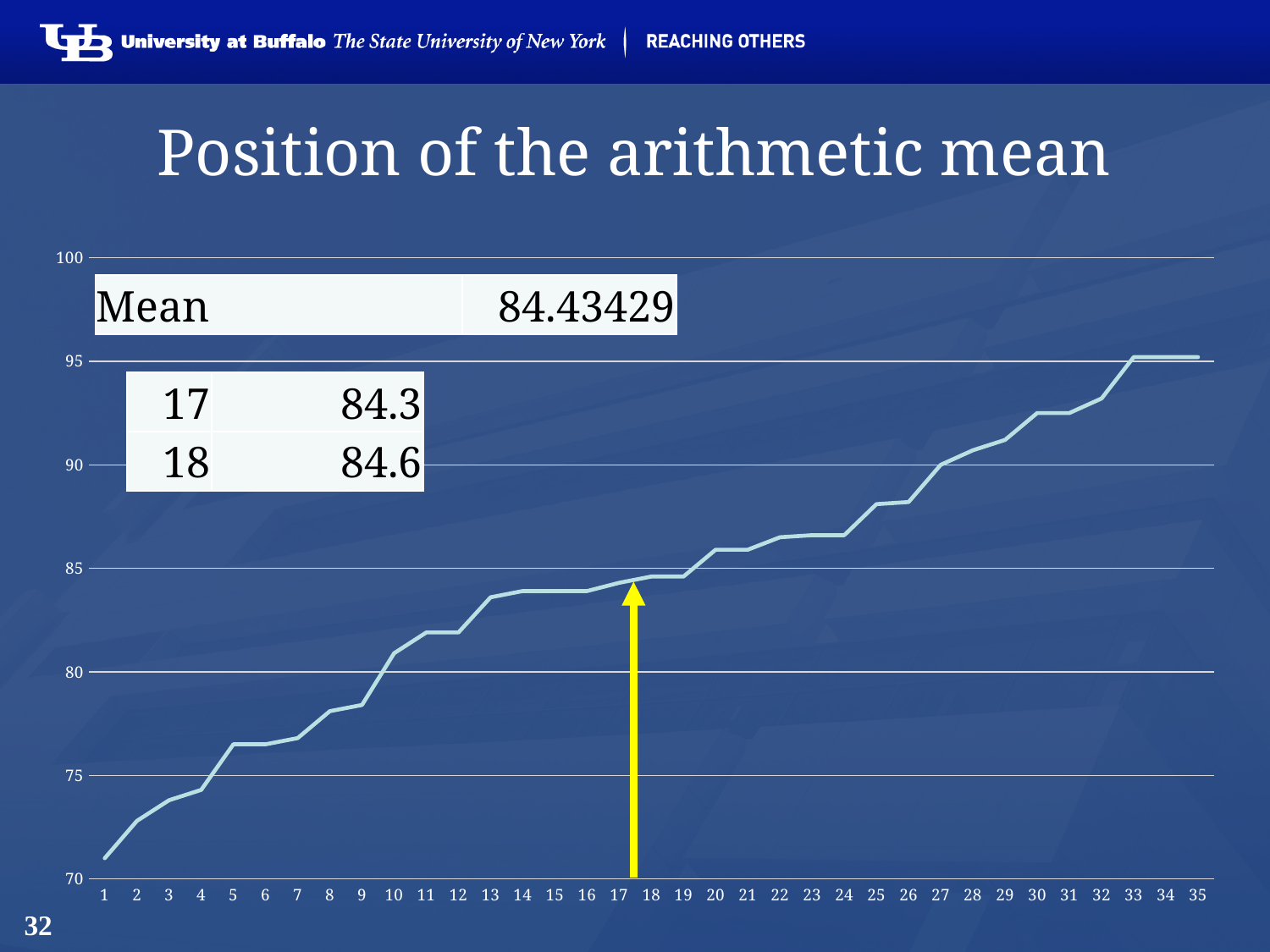
How many points are plotted along the x axis of the chart? 35 Is the value at position 9 greater or less than 80? less What is the value at position 18 according to the table on the chart? 84.6 What is the difference between the values at positions 18 and 17? 0.3 Do the values rise or fall as you move from position 1 to position 35 along the x axis? rise Is the value at position 1 greater or less than 75? less What kind of chart is shown on the slide? line chart What is the value at position 17 according to the table on the chart? 84.3 Which position on the x axis has the lowest value? 1 Which is larger, the value at position 17 or the value at position 18? 18 Is the value at position 25 greater or less than 85? greater What mean value is printed on the chart? 84.43429